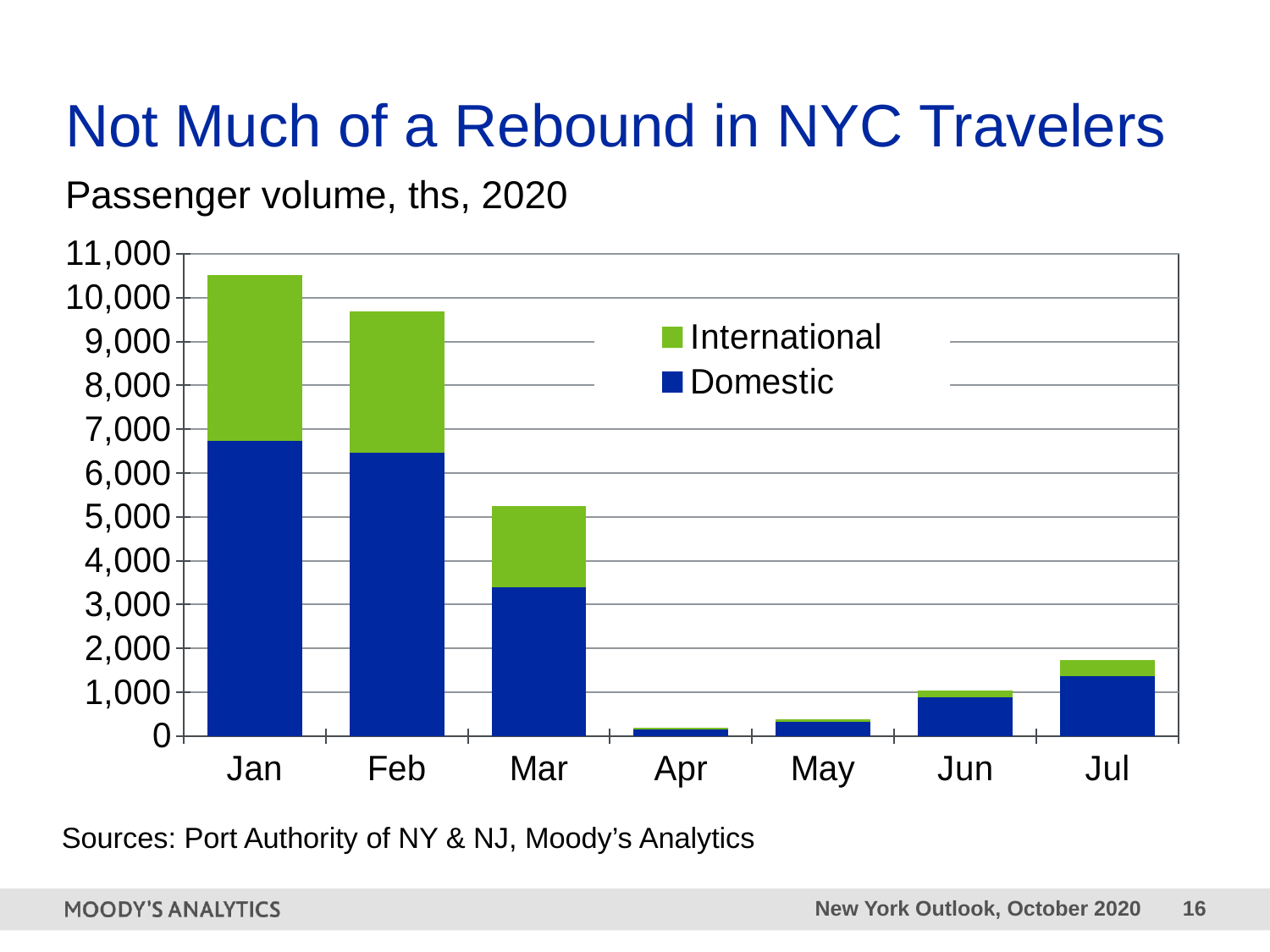
Which month has the lowest total passenger volume? Apr How many months are shown on the x axis of the chart? 7 Do total passenger volumes rise or fall from Jan to Apr? fall How many series does the chart's legend list? 2 Which series is shown in green in the chart's legend? International Is the total passenger volume for Jan greater or less than 10,000? greater What kind of chart is shown on the slide? Stacked bar chart Is the total passenger volume for Feb greater or less than 10,000? less Which month has the larger total passenger volume, Feb or Mar? Feb Which month has the highest total passenger volume? Jan Is the total passenger volume for Jul greater or less than 2,000? less